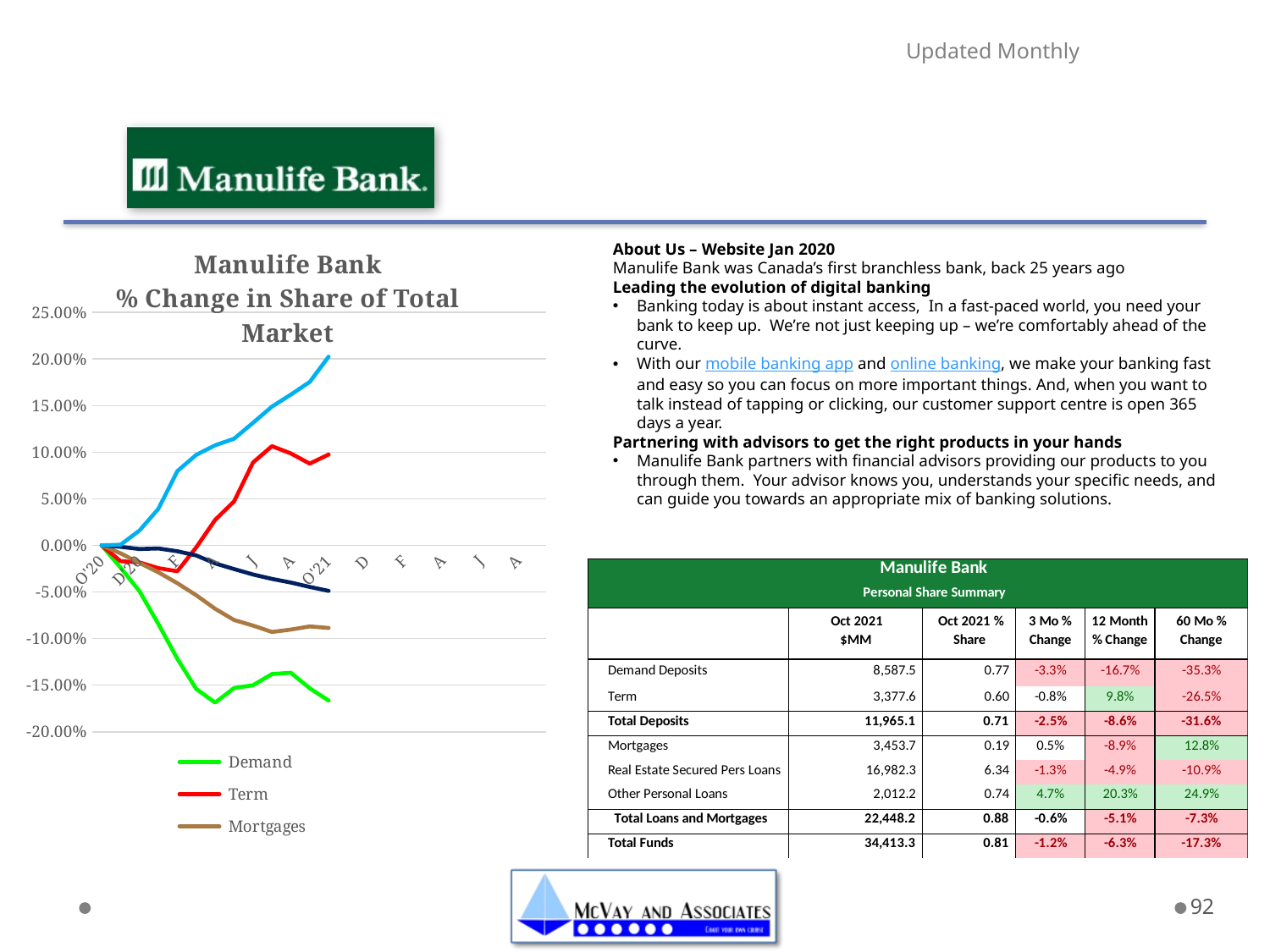
What is the title of the chart? Manulife Bank % Change in Share of Total Market Is the value for Term at O'21 greater or less than 5.00%? greater Of the series listed in the legend, which has the lowest value at O'21? Demand Is the value for Demand at O'21 greater or less than -15.00%? less Is the value for Mortgages at O'21 greater or less than -5.00%? less At O'21, which is higher, Term or Demand? Term How many series does the chart's legend list? 3 Does the Demand line rise or fall from O'20 to A'21? fall What is the value for Demand at O'20? 0.00% What kind of chart is shown on the slide? line chart What colour is the Demand line in the chart? green Does the Term line rise or fall overall from O'20 to O'21? rise